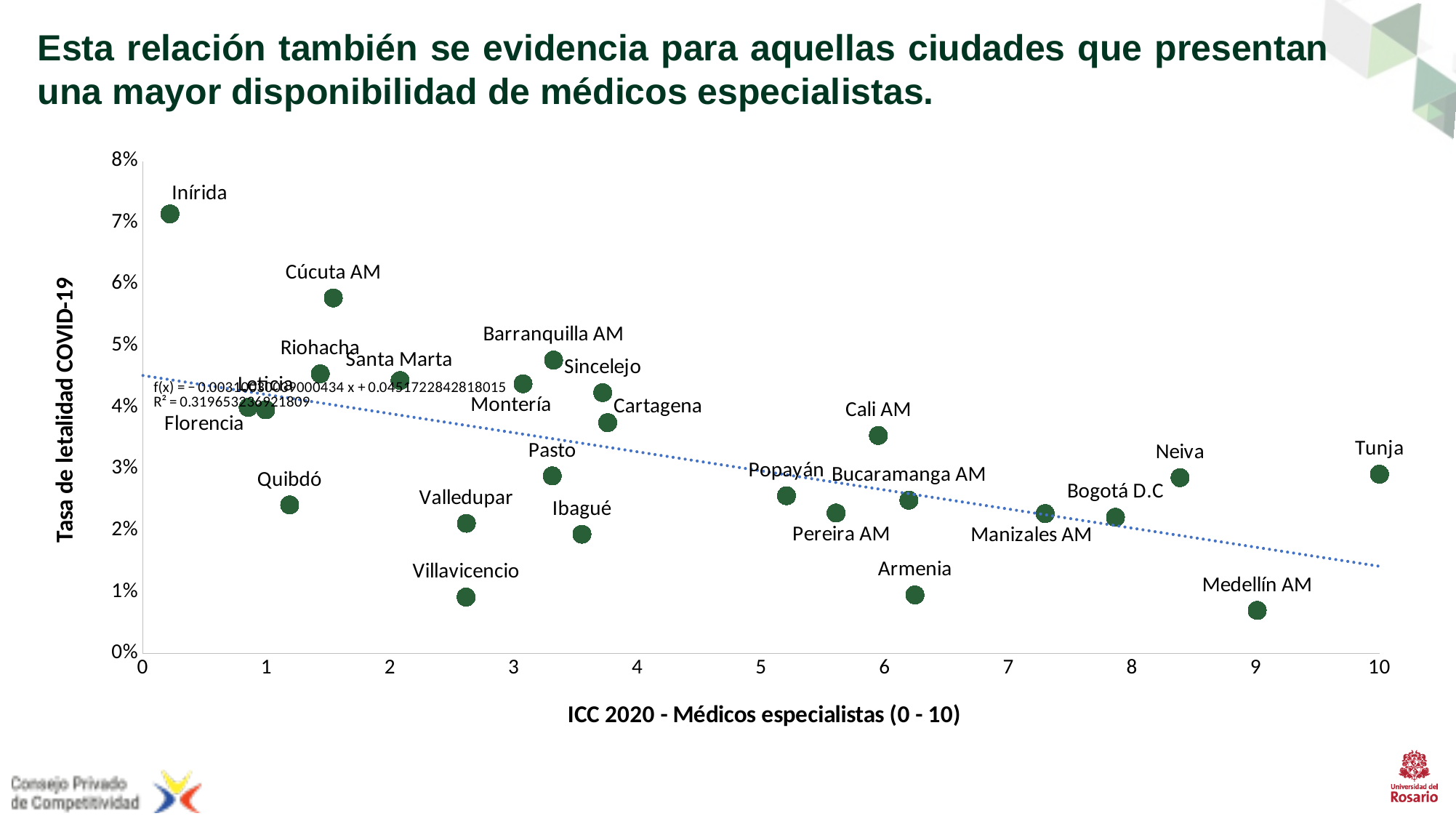
According to the dotted trend line, does the lethality rate rise or fall as the ICC specialist doctors score increases? fall Is the lethality rate for Cúcuta AM greater or less than 5%? greater Is the lethality rate for Inírida greater or less than 6%? greater Which city has the highest ICC 2020 specialist doctors score? Tunja Which city has the lowest COVID-19 lethality rate in the chart? Medellín AM What kind of chart is shown on the slide? scatter chart What is the title of the x axis? ICC 2020 - Médicos especialistas (0 - 10) Is the lethality rate for Medellín AM greater or less than 1%? less Which city has the highest COVID-19 lethality rate in the chart? Inírida Which city has a higher COVID-19 lethality rate, Inírida or Cúcuta AM? Inírida